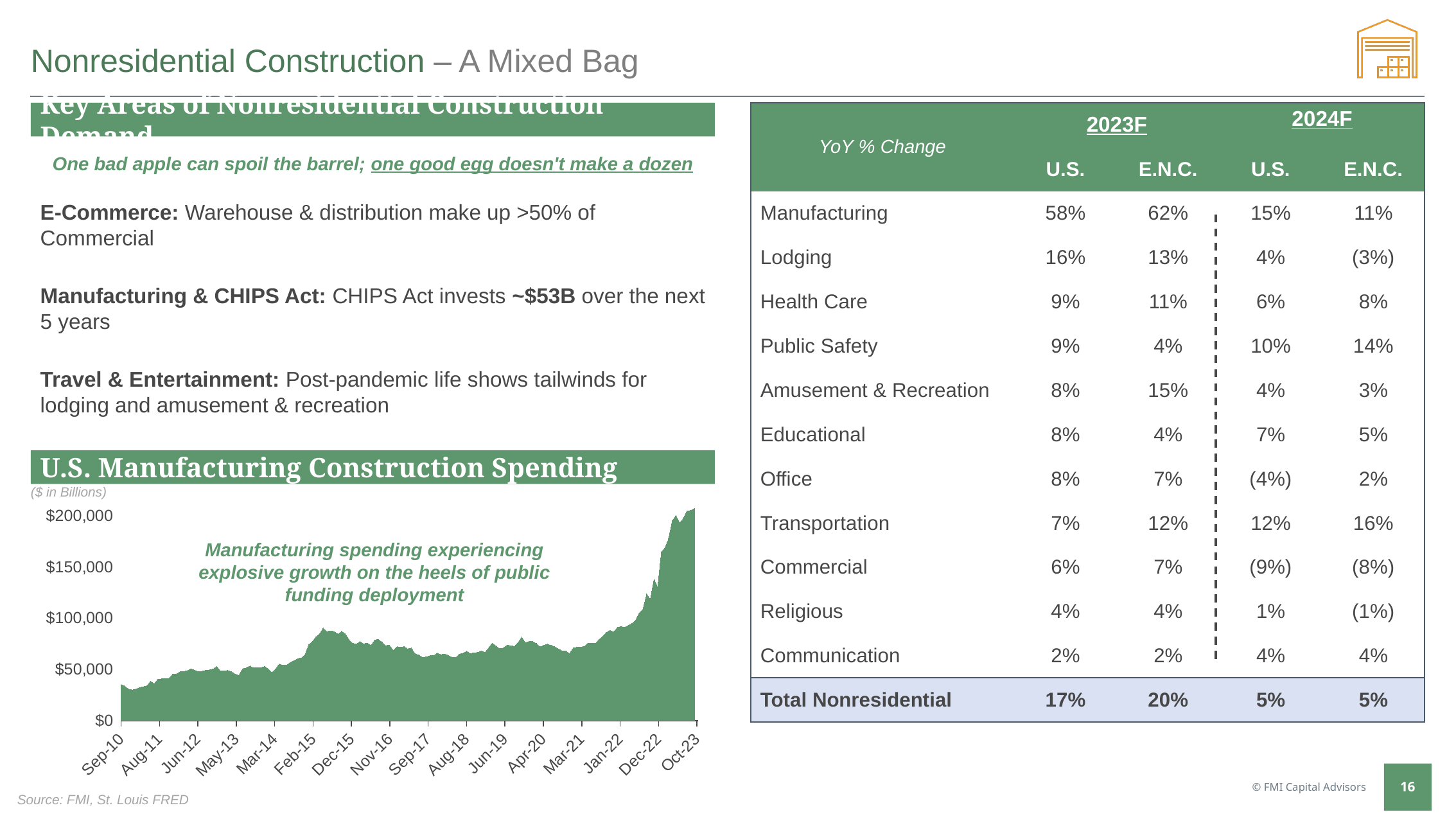
In the U.S. Manufacturing Construction Spending chart, which labeled date on the x axis has the lowest spending? Sep-10 In the U.S. Manufacturing Construction Spending chart, do values generally rise or fall from Sep-10 to Oct-23? Rise What is the highest tick value shown on the y axis of the U.S. Manufacturing Construction Spending chart? $200,000 In the U.S. Manufacturing Construction Spending chart, which labeled date on the x axis has the highest spending? Oct-23 In the U.S. Manufacturing Construction Spending chart, is the value at Sep-10 greater or less than $50,000? less What unit note appears under the title of the U.S. Manufacturing Construction Spending chart? ($ in Billions) In the U.S. Manufacturing Construction Spending chart, is spending higher at Feb-15 or at Aug-11? Feb-15 How many date labels are shown on the x axis of the U.S. Manufacturing Construction Spending chart? 16 In the U.S. Manufacturing Construction Spending chart, is the value at Mar-21 greater or less than $100,000? less What kind of chart is the U.S. Manufacturing Construction Spending chart? Area chart In the U.S. Manufacturing Construction Spending chart, is the value at Oct-23 greater or less than $150,000? greater